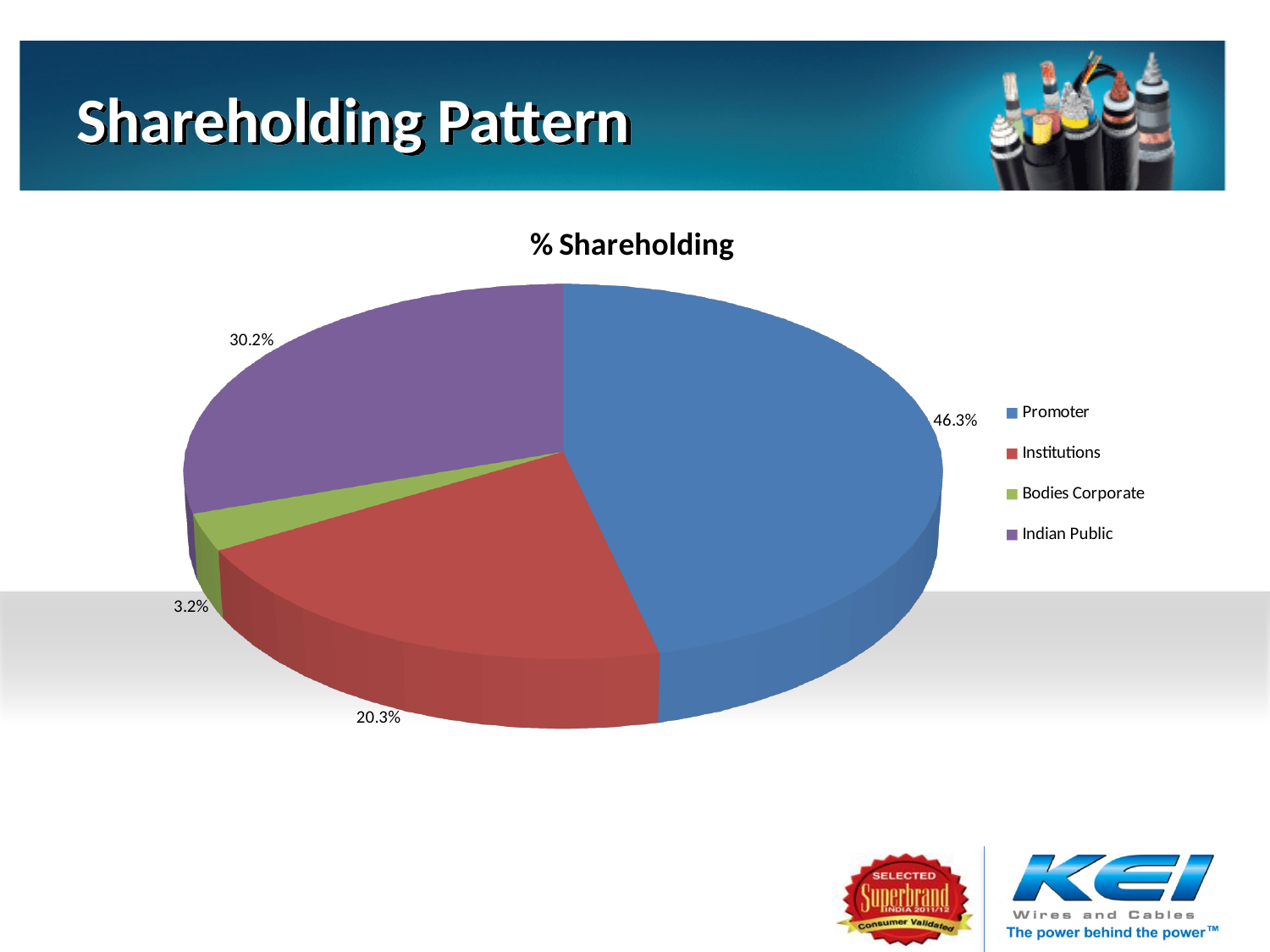
Which colour represents Institutions in the legend? red What percentage of shareholding is held by Institutions? 20.3% What percentage of shareholding is held by Indian Public? 30.2% Which category holds the largest share? Promoter What percentage of shareholding is held by Promoter? 46.3% What is the difference between the Promoter share and the Indian Public share? 16.1% What is the chart's title? % Shareholding What type of chart is shown on the slide? pie chart Which is larger, the Institutions share or the Indian Public share? Indian Public Which category holds the smallest share? Bodies Corporate What percentage of shareholding is held by Bodies Corporate? 3.2% How many categories does the pie chart show? 4